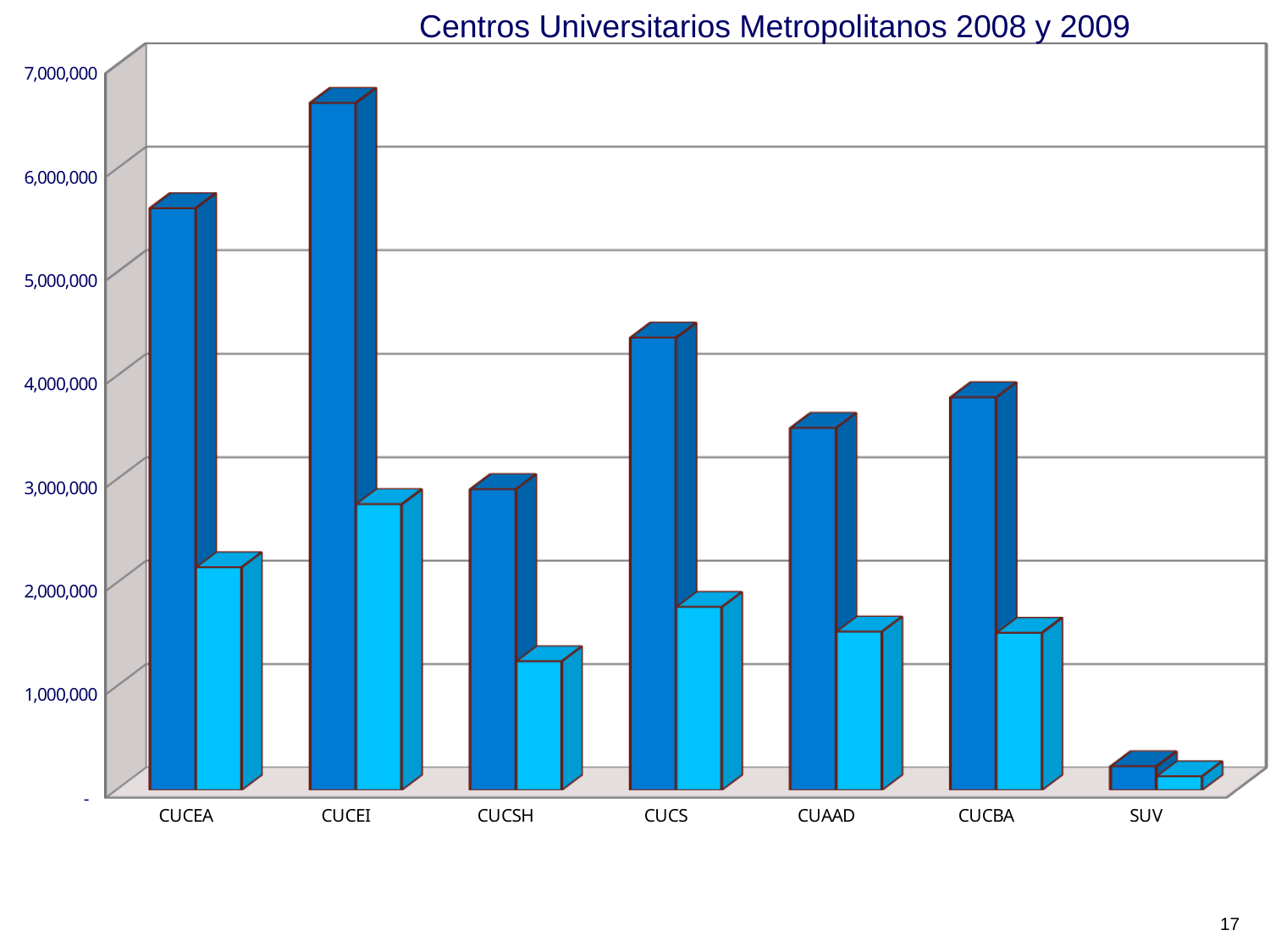
Which category has the tallest dark blue bar? CUCEI Is the dark blue bar for CUCBA greater or less than 4,000,000? less Which is larger, the dark blue bar for CUCEA or the dark blue bar for CUCS? CUCEA Which category has the shortest dark blue bar? SUV Is the dark blue bar for CUCEI greater or less than 6,000,000? greater Which category has the tallest light blue bar? CUCEI What is the title of the chart? Centros Universitarios Metropolitanos 2008 y 2009 Is the light blue bar for CUCS greater or less than 2,000,000? less What kind of chart is shown on the slide? bar chart How many categories are shown on the x axis of the chart? 7